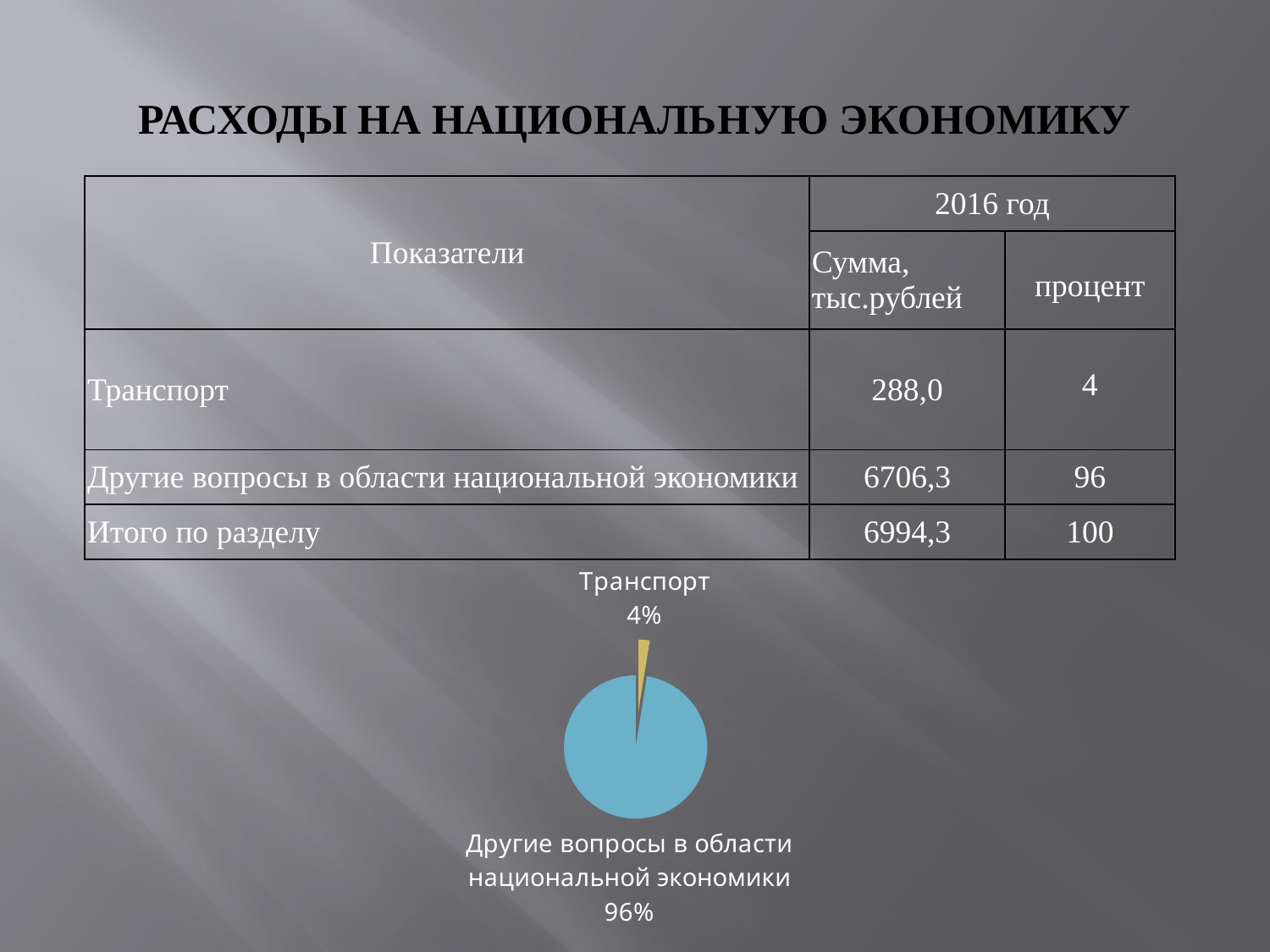
What colour is the Другие вопросы в области национальной экономики slice in the pie chart? blue What kind of chart is shown on the slide? pie chart What share of the pie chart does Транспорт represent? 4% Which slice of the pie chart is the largest? Другие вопросы в области национальной экономики What colour is the Транспорт slice in the pie chart? yellow How many slices does the pie chart have? 2 Which slice of the pie chart is the smallest? Транспорт What is the total of the two percentages shown on the pie chart? 100% What share of the pie chart does Другие вопросы в области национальной экономики represent? 96% What is the difference in percentage points between the two slices of the pie chart? 92 In the pie chart, which is larger: Транспорт or Другие вопросы в области национальной экономики? Другие вопросы в области национальной экономики